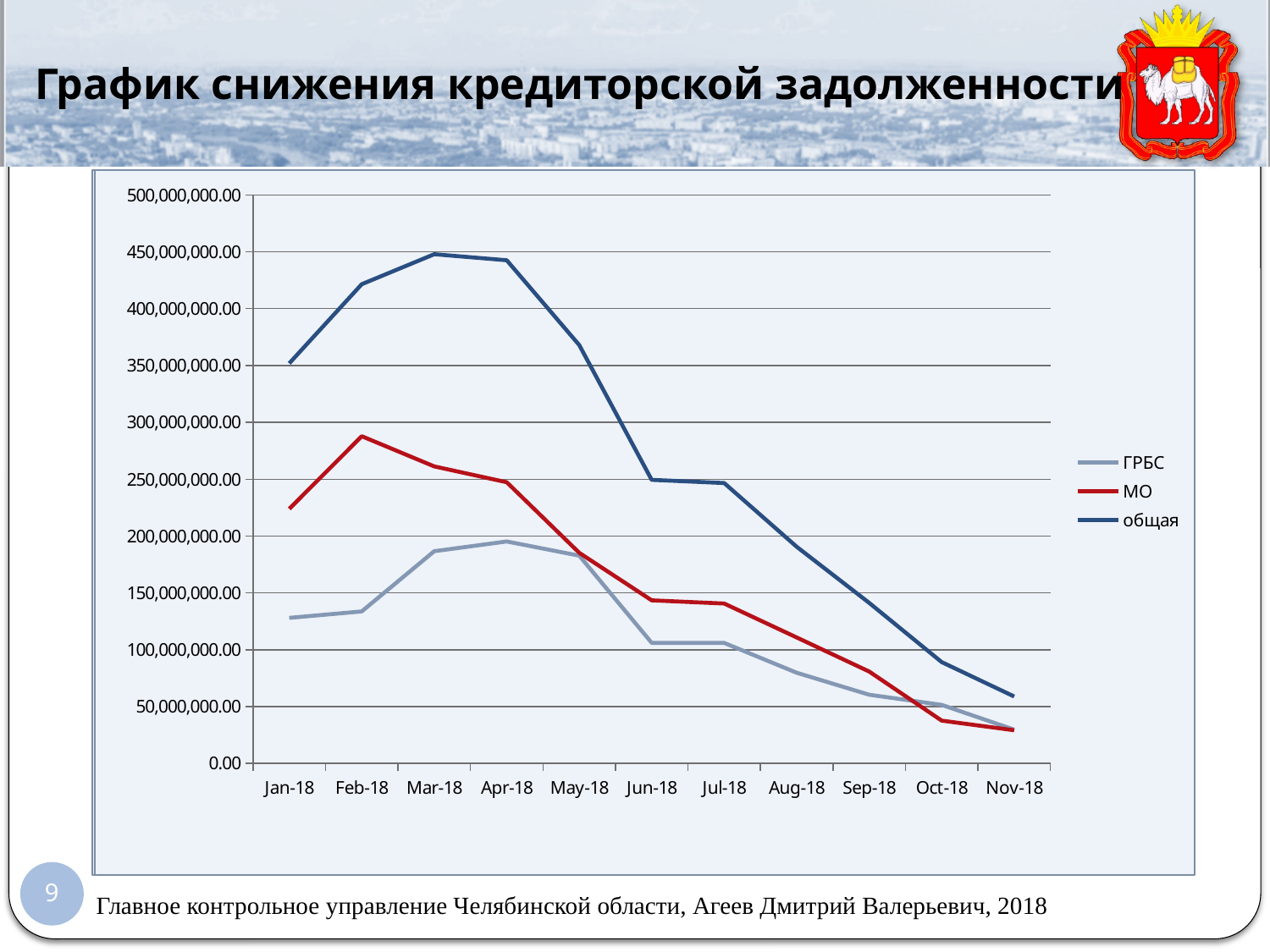
In which month does the общая series reach its highest value? Mar-18 What is the title of the slide containing the chart? График снижения кредиторской задолженности What kind of chart is shown on the slide? line chart Is the value of МО in Feb-18 greater or less than 250,000,000.00? greater Is the value of общая in Jan-18 greater or less than 300,000,000.00? greater Does the общая series rise or fall from Mar-18 to Nov-18? fall In which month does the МО series reach its highest value? Feb-18 Is the value of МО in Oct-18 greater or less than 50,000,000.00? less In which month does the общая series reach its lowest value? Nov-18 How many series does the legend list? 3 How many months are plotted along the x axis? 11 Which series has the larger value in Jun-18, МО or ГРБС? МО